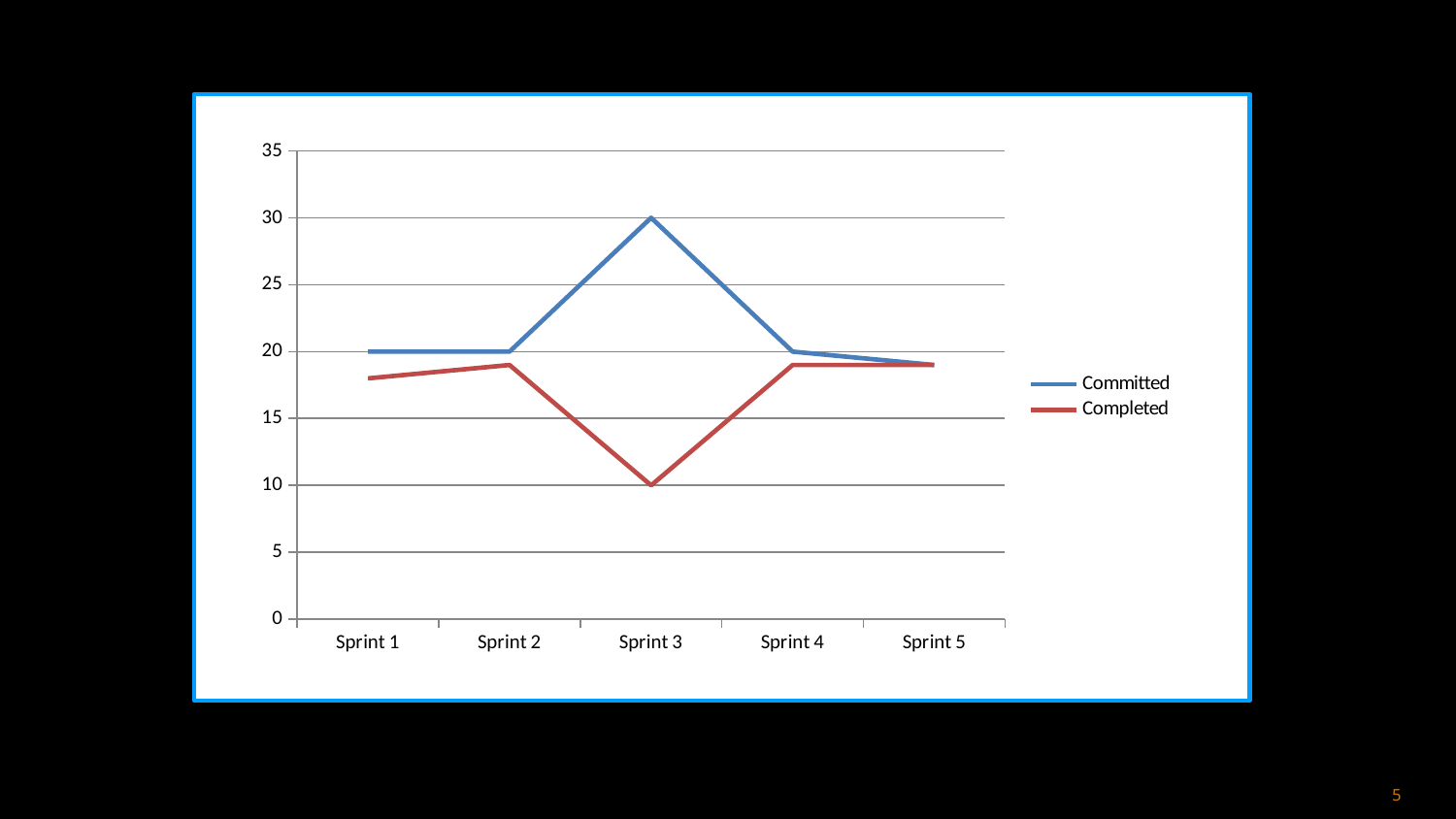
What is the difference between Committed and Completed in Sprint 3? 20 Which is larger in Sprint 3, Committed or Completed? Committed What is the Completed value for Sprint 3? 10 How many series does the legend list? 2 In which sprint is the Completed value lowest? Sprint 3 What kind of chart is shown on the slide? line chart How many sprints are shown on the x axis? 5 In which sprint is the Committed value highest? Sprint 3 Which colour is used for the Completed series? red What is the Committed value for Sprint 3? 30 What is the Committed value for Sprint 1? 20 Is the Completed value for Sprint 1 greater or less than 20? less